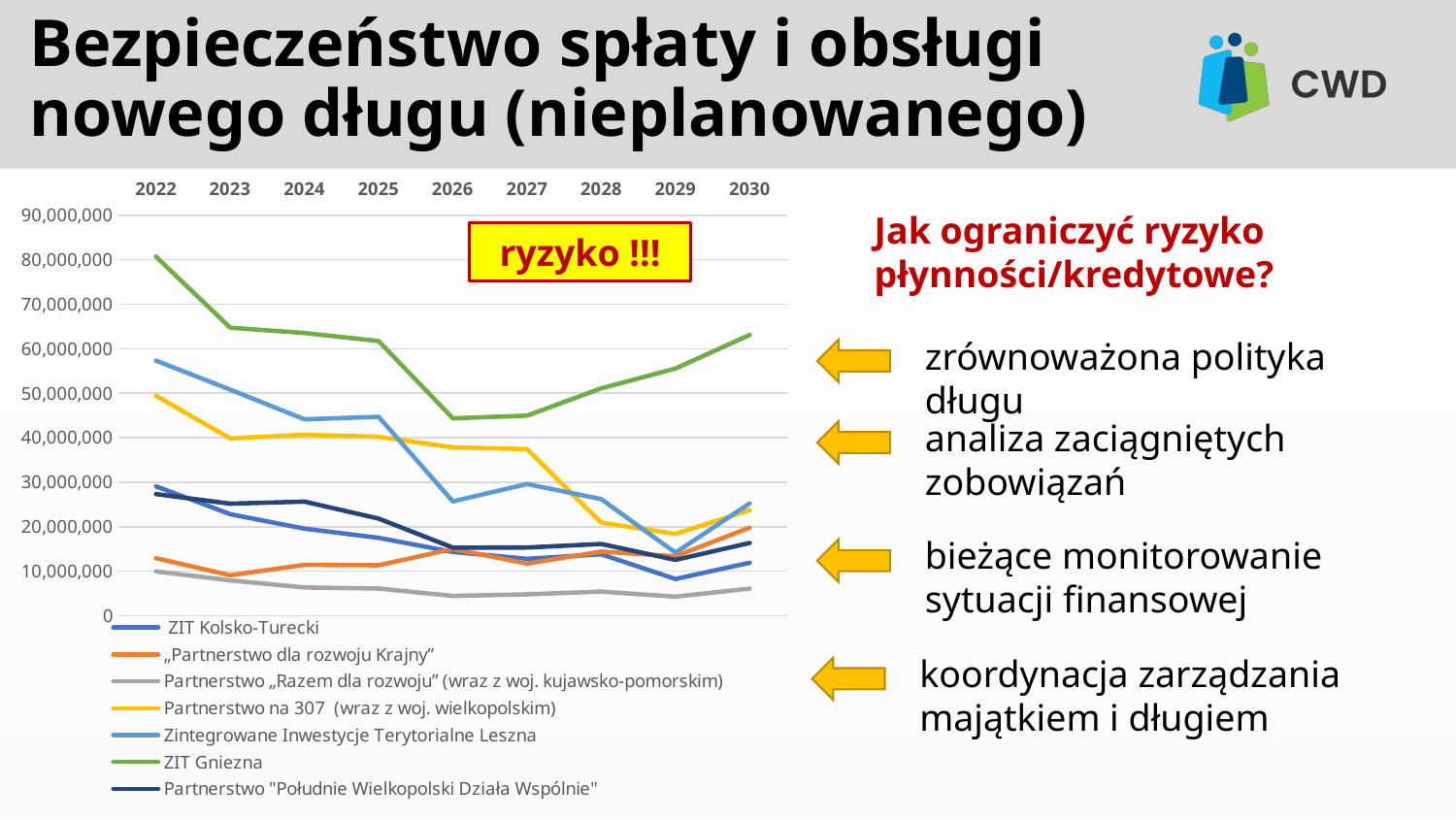
Is the value for ZIT Gniezna in 2026 greater or less than 40,000,000? greater Does the value for ZIT Gniezna rise or fall from 2022 to 2026? fall Is the value for ZIT Kolsko-Turecki in 2022 greater or less than 20,000,000? greater How many series does the chart's legend list? 7 Which series has the lowest value in 2030? Partnerstwo „Razem dla rozwoju” (wraz z woj. kujawsko-pomorskim) Is the value for Zintegrowane Inwestycje Terytorialne Leszna in 2022 greater or less than 50,000,000? greater What text is written in the red-bordered yellow box on the chart? ryzyko !!! What kind of chart is shown on the slide? line chart Which series has the highest value in 2022? ZIT Gniezna How many years are shown along the x axis of the chart? 9 In 2030, which is larger: ZIT Gniezna or Zintegrowane Inwestycje Terytorialne Leszna? ZIT Gniezna